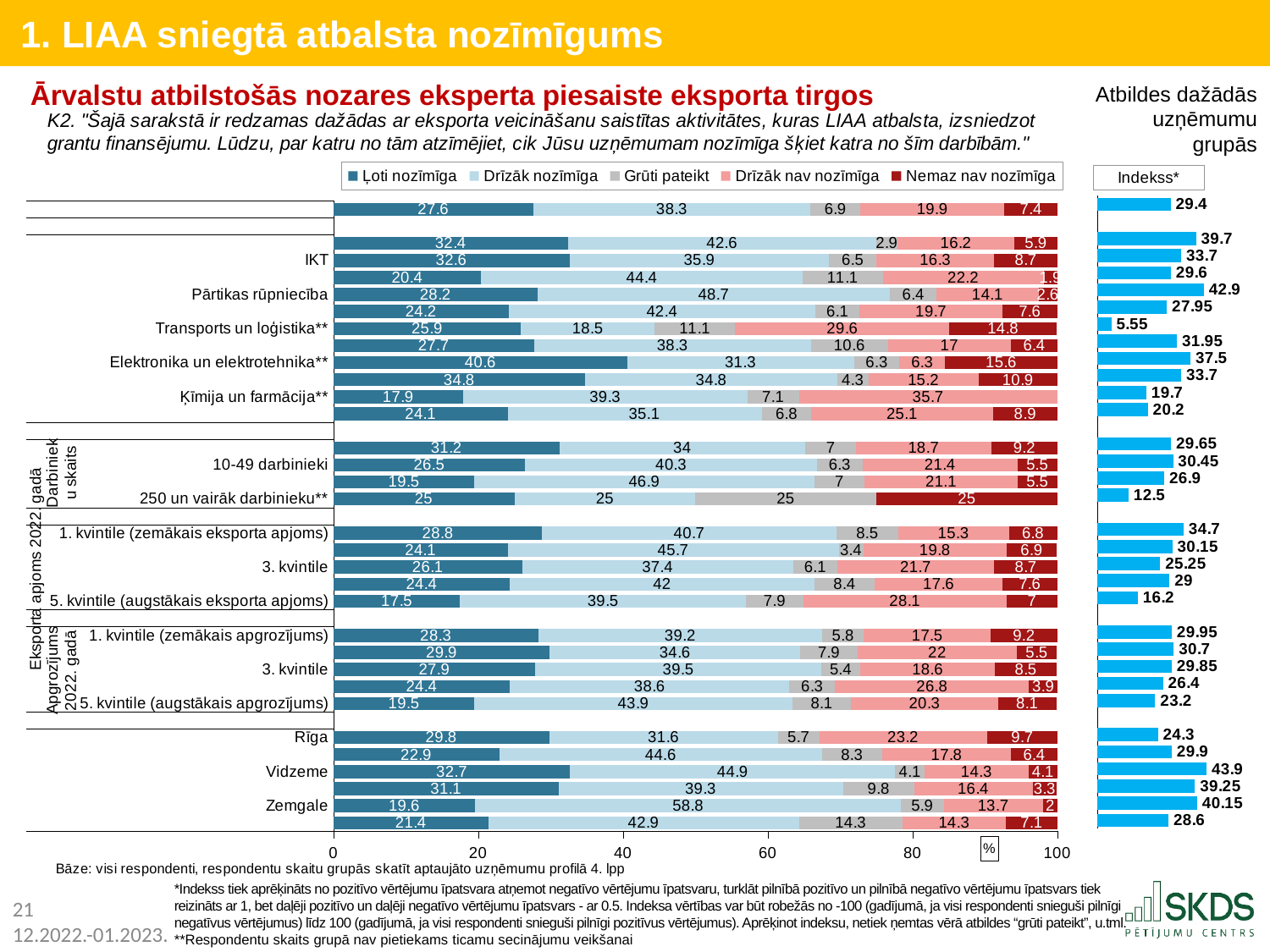
In the 'Indekss*' chart, is the value for Transports un loģistika** greater or less than 10? less In the main chart, what is the 'Drīzāk nozīmīga' value for Zemgale? 58.8 What kind of chart is the main chart on the slide? bar chart In the main chart, which has the larger 'Ļoti nozīmīga' value, Rīga or Vidzeme? Vidzeme In the main chart, what is the total of the stacked bar for Ķīmija un farmācija**? 100 In the 'Indekss*' chart on the right, what is the index value for Pārtikas rūpniecība? 42.9 In the main chart, what is the 'Ļoti nozīmīga' value for Elektronika un elektrotehnika**? 40.6 In the 'Indekss*' chart, which of the labelled groups has the lowest index value? Transports un loģistika** How many series does the legend of the main chart list? 5 In the main chart, what is the 'Nemaz nav nozīmīga' value for Transports un loģistika**? 14.8 In the main chart's legend, which series is shown in dark red? Nemaz nav nozīmīga In the main chart, what is the difference between the 'Drīzāk nozīmīga' values for Zemgale and Rīga? 27.2